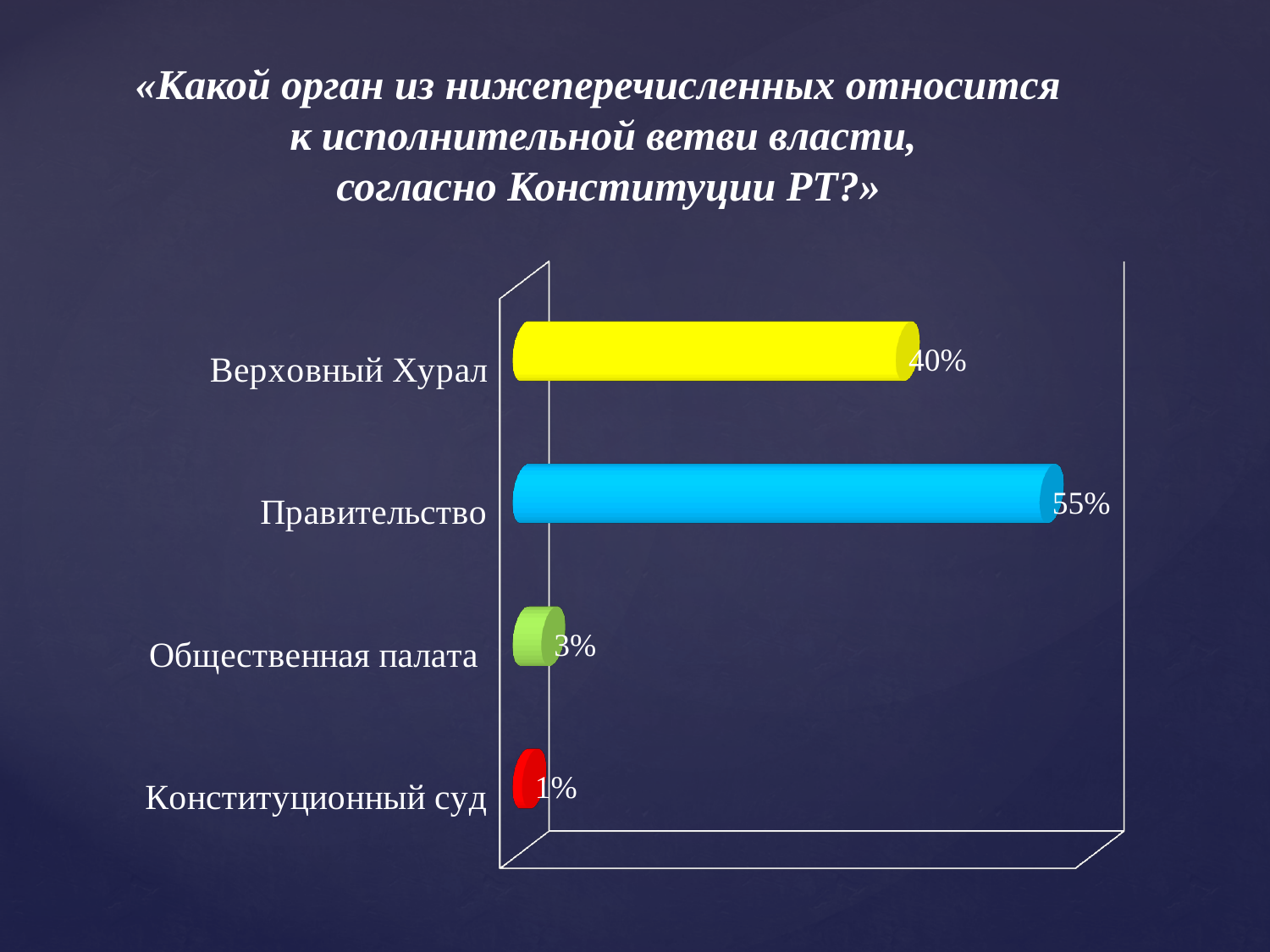
What is the value for Общественная палата? 3% Which category has the lowest value? Конституционный суд What is the difference between the values for Правительство and Верховный Хурал? 15% What colour is the bar for Правительство? blue What is the difference between the values for Общественная палата and Конституционный суд? 2% Which is larger, the value for Верховный Хурал or the value for Правительство? Правительство How many categories are shown in the chart? 4 What is the value for Правительство? 55% What is the value for Верховный Хурал? 40% What kind of chart is shown on the slide? bar chart What is the value for Конституционный суд? 1% Which category has the highest value? Правительство